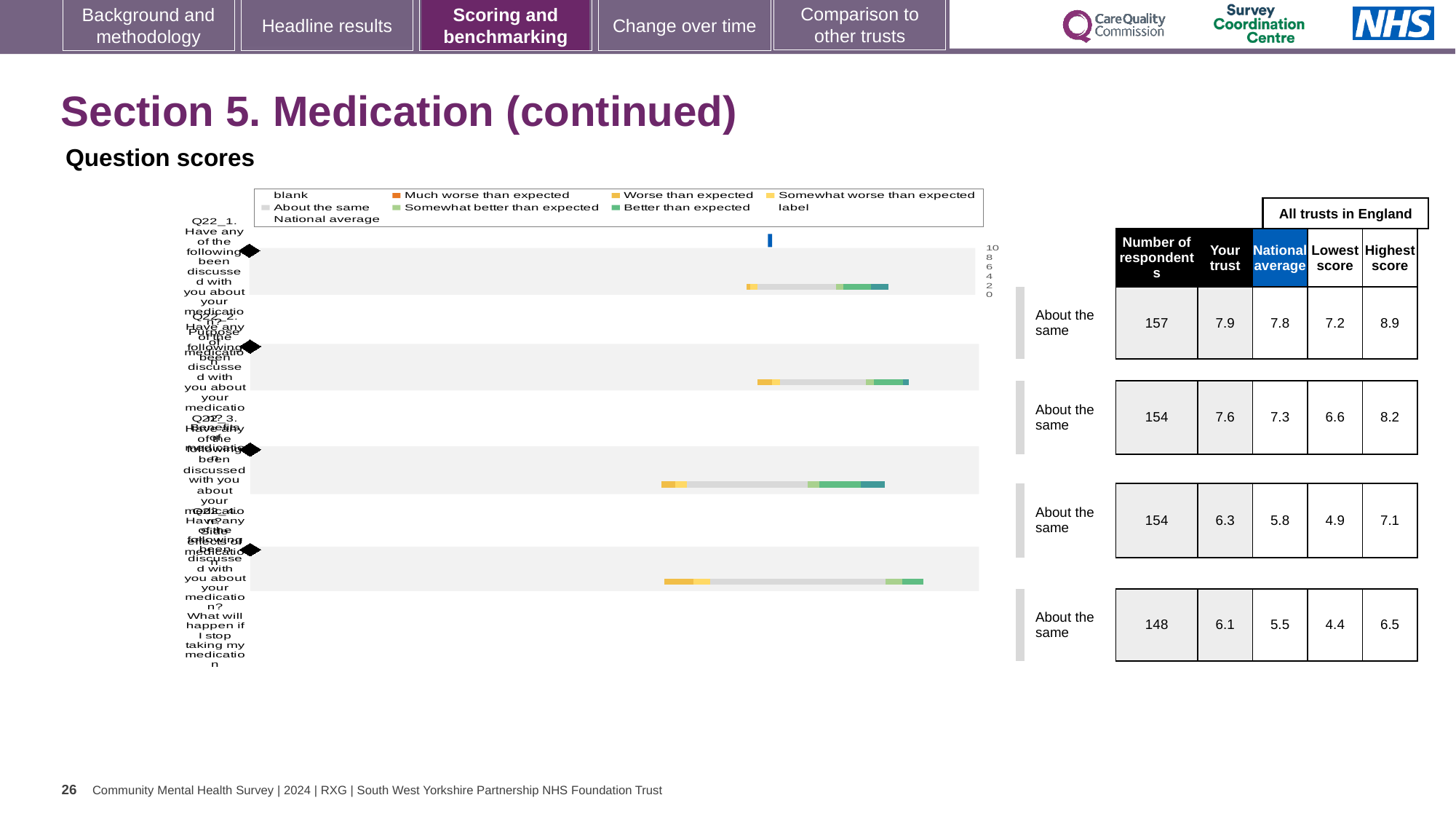
What benchmark label is shown next to each of the four question rows? About the same How many question rows (bars) are plotted in the chart? 4 In the table beside the chart, what is the national average for the fourth question row? 5.5 In the chart legend, what colour represents 'About the same'? light grey In the table beside the chart, is the 'Your trust' score for the second row larger or smaller than the national average for that row? larger In the table beside the chart, what is the 'Your trust' score for the first question row? 7.9 In the table beside the chart, what is the number of respondents for the first question row? 157 In the table beside the chart, what is the difference between 'Your trust' and the national average for the third question row? 0.5 In the table beside the chart, what is the highest score for the second question row? 8.2 What kind of chart is shown under 'Question scores'? bar chart In the table beside the chart, which question row has the lowest 'Your trust' score? the fourth row (6.1) In the chart legend, what colour represents 'Much worse than expected'? orange